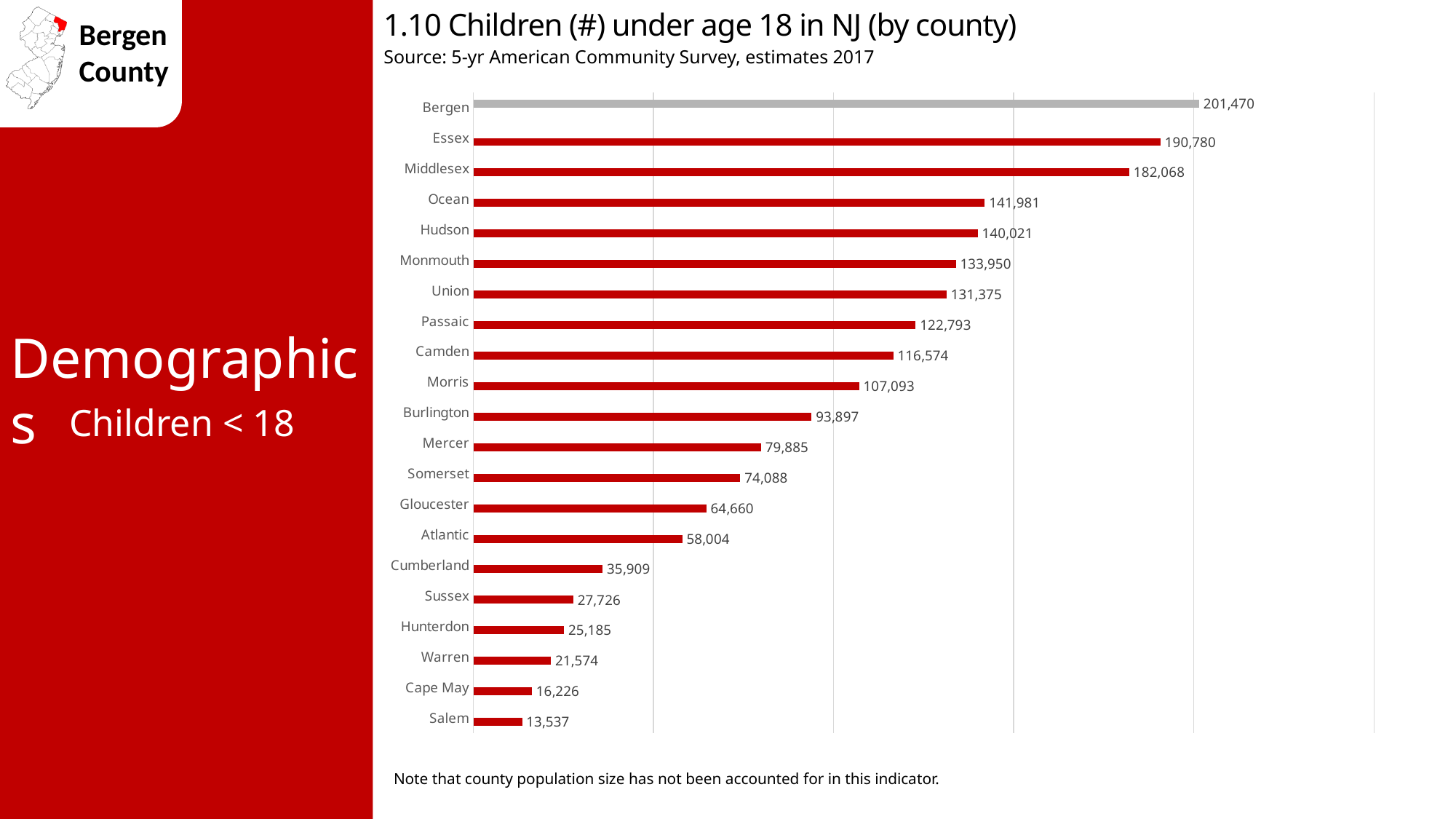
What is the difference between the number of children under 18 in Ocean and Hudson counties? 1,960 Which county has more children under age 18, Passaic or Camden? Passaic What is the number of children under age 18 in Cape May County? 16,226 Which county has the lowest number of children under age 18? Salem What type of chart is used to show children under age 18 by county? Bar chart Which county has more children under age 18, Mercer or Somerset? Mercer What is the difference between the number of children under 18 in Bergen and Essex counties? 10,690 Which county has the highest number of children under age 18? Bergen What is the number of children under age 18 in Bergen County? 201,470 What is the number of children under age 18 in Morris County? 107,093 What is the source of the data shown in the chart? 5-yr American Community Survey, estimates 2017 How many counties are shown in the chart? 21